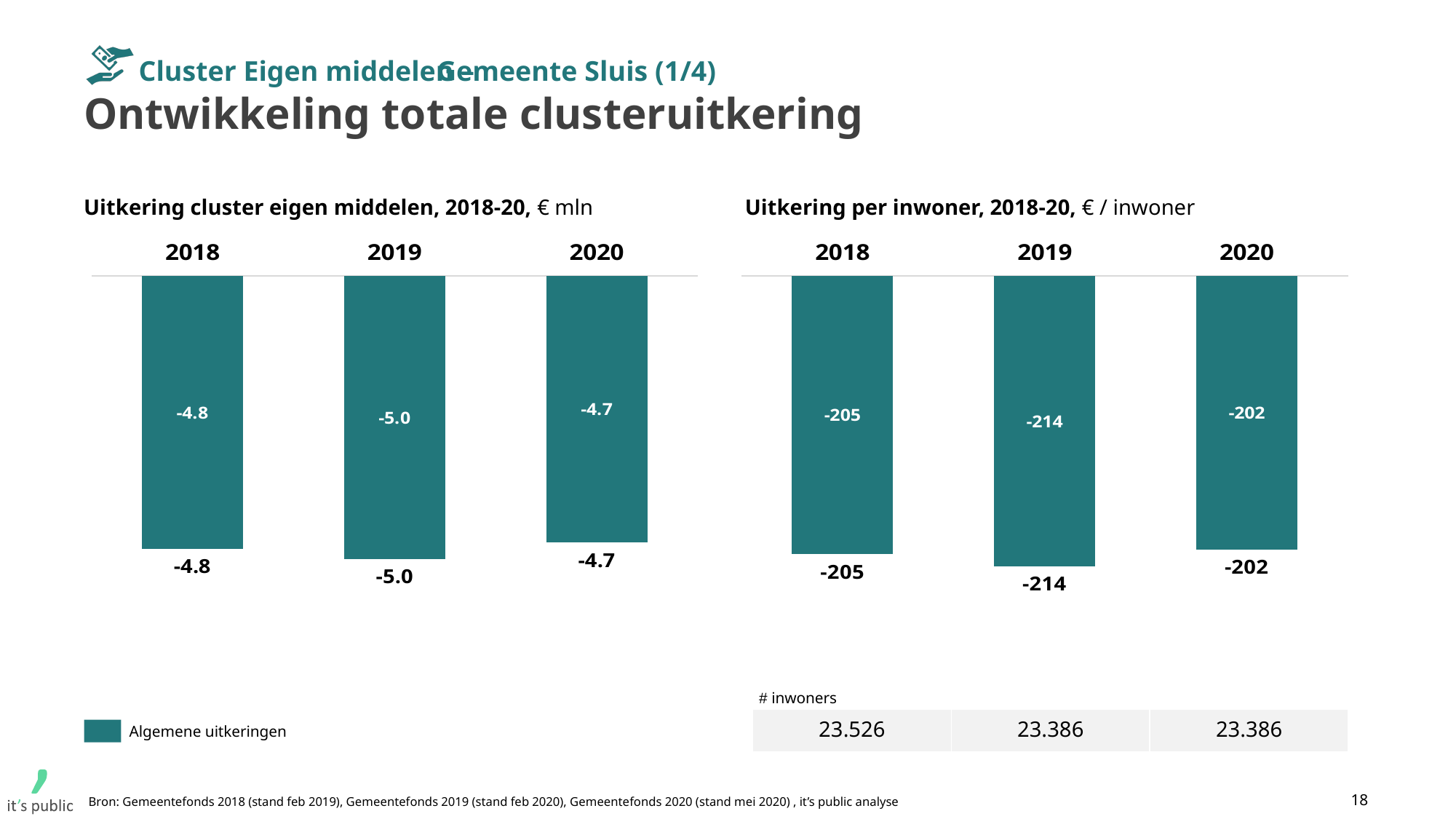
In the chart 'Uitkering cluster eigen middelen, 2018-20', which year has the lowest (most negative) value? 2019 In the chart 'Uitkering per inwoner, 2018-20', what is the value for 2018? -205 How many years are shown in the chart 'Uitkering cluster eigen middelen, 2018-20'? 3 In the chart 'Uitkering per inwoner, 2018-20', which year has the highest (least negative) value? 2020 What is the legend entry shown for the charts on the slide? Algemene uitkeringen In the chart 'Uitkering cluster eigen middelen, 2018-20', what is the difference between the 2018 value and the 2019 value? 0.2 What kind of chart is 'Uitkering per inwoner, 2018-20'? Bar chart In the chart 'Uitkering cluster eigen middelen, 2018-20', what is the value for 2019? -5.0 In the chart 'Uitkering per inwoner, 2018-20', which year has the larger (less negative) value, 2018 or 2019? 2018 In the chart 'Uitkering cluster eigen middelen, 2018-20', what is the value for 2020? -4.7 In the chart 'Uitkering per inwoner, 2018-20', what is the value for 2019? -214 In the chart 'Uitkering per inwoner, 2018-20', what is the difference between the 2018 value and the 2019 value? 9